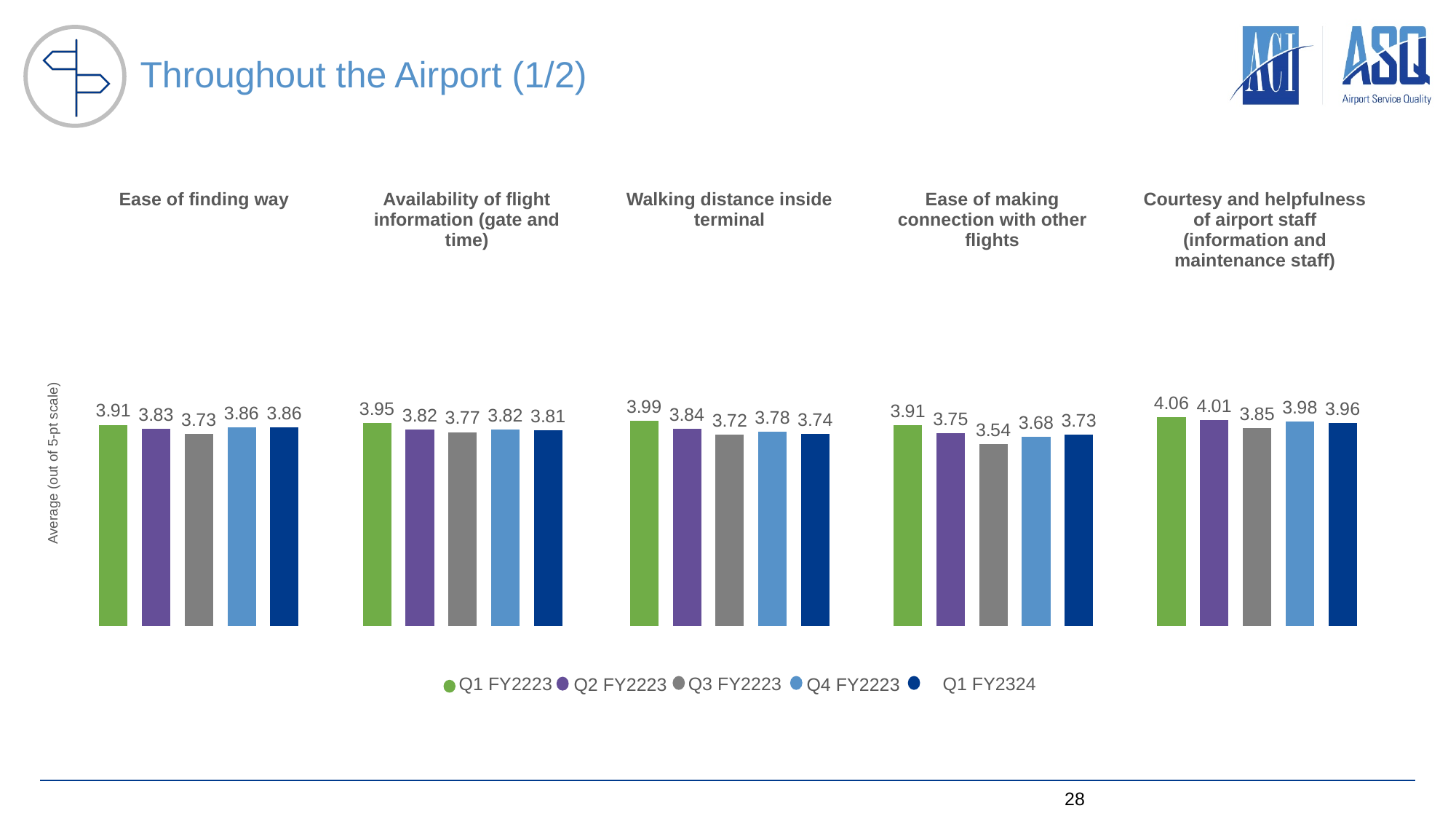
What is the Q1 FY2324 value for Ease of finding way? 3.86 What is the Q1 FY2223 value for Courtesy and helpfulness of airport staff (information and maintenance staff)? 4.06 What kind of chart is shown on the slide? Bar chart How many categories are shown on the chart? 5 Which is larger for Availability of flight information (gate and time): the Q1 FY2223 value or the Q1 FY2324 value? Q1 FY2223 Which category has the highest Q1 FY2223 value? Courtesy and helpfulness of airport staff (information and maintenance staff) How many series does the legend list? 5 What is the label on the vertical axis of the chart? Average (out of 5-pt scale) Which category has the lowest Q3 FY2223 value? Ease of making connection with other flights What is the difference between the Q1 FY2223 and Q3 FY2223 values for Walking distance inside terminal? 0.27 What is the Q3 FY2223 value for Ease of making connection with other flights? 3.54 What is the Q4 FY2223 value for Walking distance inside terminal? 3.78